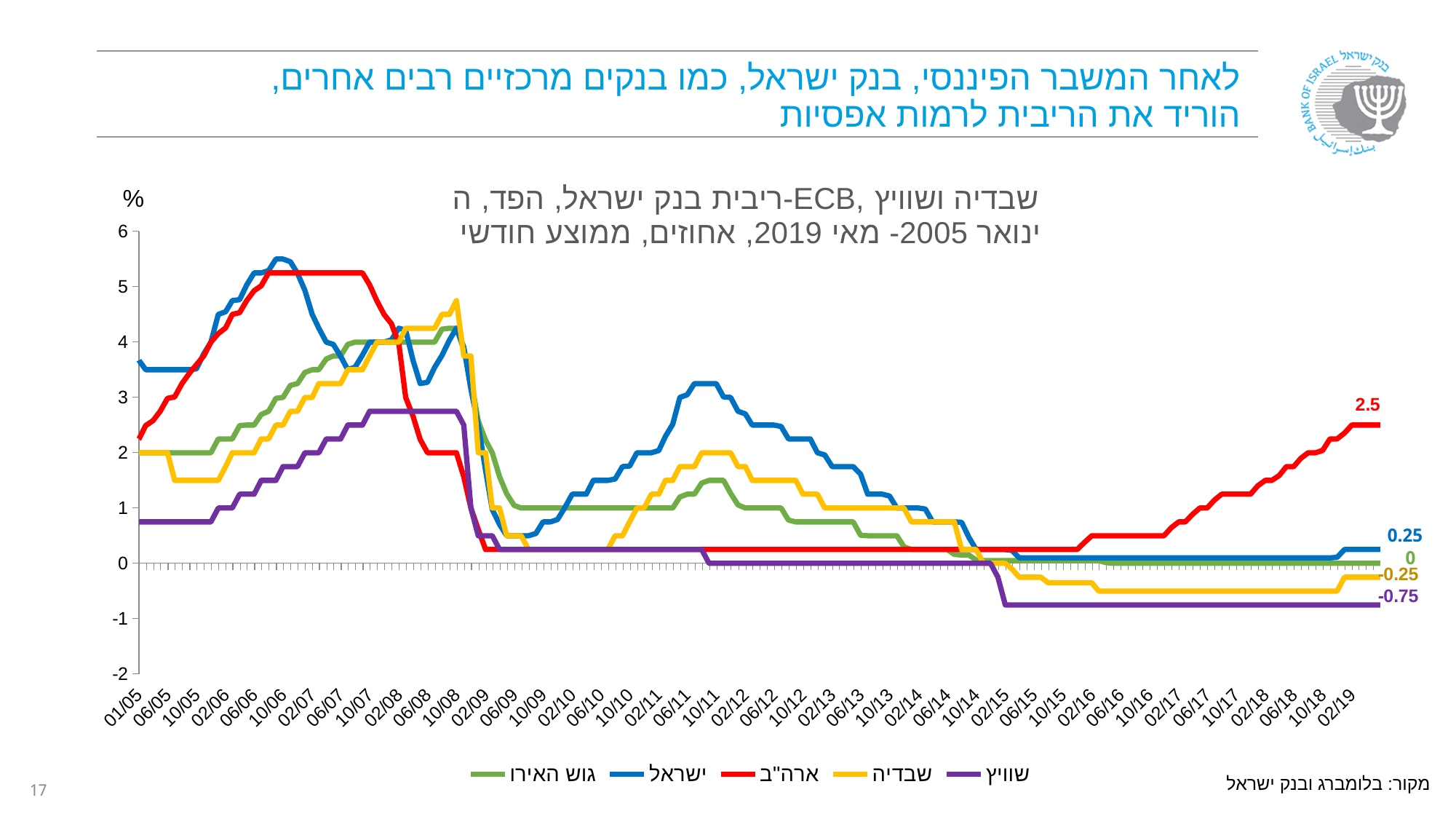
What is the difference between the end values of ארה"ב (2.5) and ישראל (0.25)? 2.25 What type of chart is shown on the slide? line chart What is the final labelled value for שוויץ (the purple line)? -0.75 Which series has the highest value at the end of the period (the labelled end values)? ארה"ב Which series has the lowest value at the end of the period (the labelled end values)? שוויץ What is the final labelled value for ארה"ב (the red line) at the end of the series? 2.5 How many series does the legend list? 5 What is the final labelled value for ישראל (the blue line)? 0.25 Is the value for ישראל around 10/06 greater or less than 5? greater At the end of the period, which is larger: the value for שבדיה or the value for שוויץ? שבדיה What is the final labelled value for גוש האירו (the green line)? 0 What is the final labelled value for שבדיה (the yellow line)? -0.25